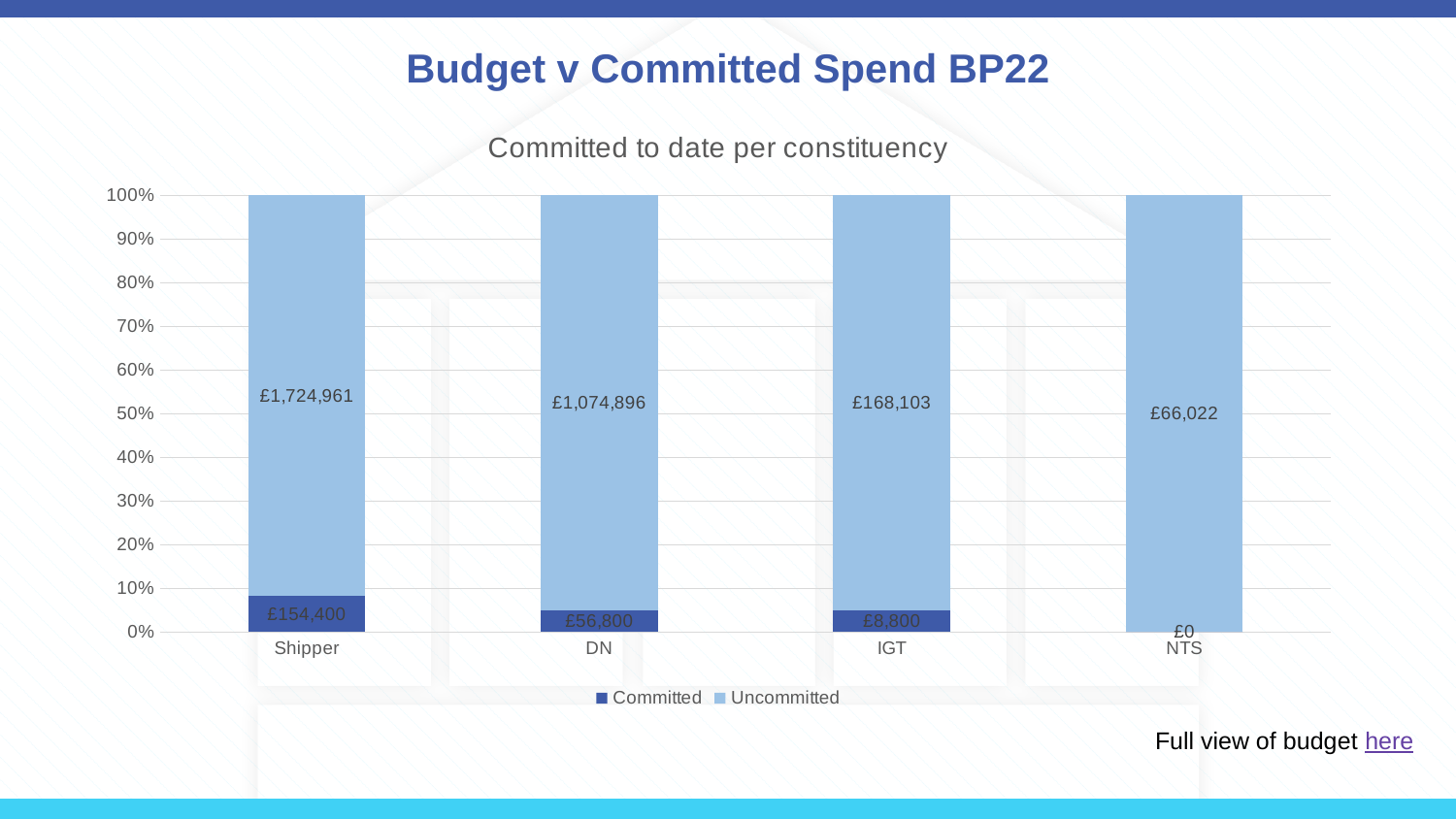
What is the total of the Committed and Uncommitted values for IGT? £176,903 What is the Uncommitted value for IGT? £168,103 What is the difference between the Committed values for Shipper and DN? £97,600 What is the Uncommitted value for DN? £1,074,896 Which constituency has the lowest Uncommitted value? NTS Which is larger, the Uncommitted value for IGT or the Uncommitted value for NTS? IGT What is the Committed value for NTS? £0 How many constituencies are shown on the x axis? 4 What is the Committed value for Shipper? £154,400 Which constituency has the highest Committed value? Shipper How many series does the legend list? 2 What kind of chart is shown? Stacked bar chart